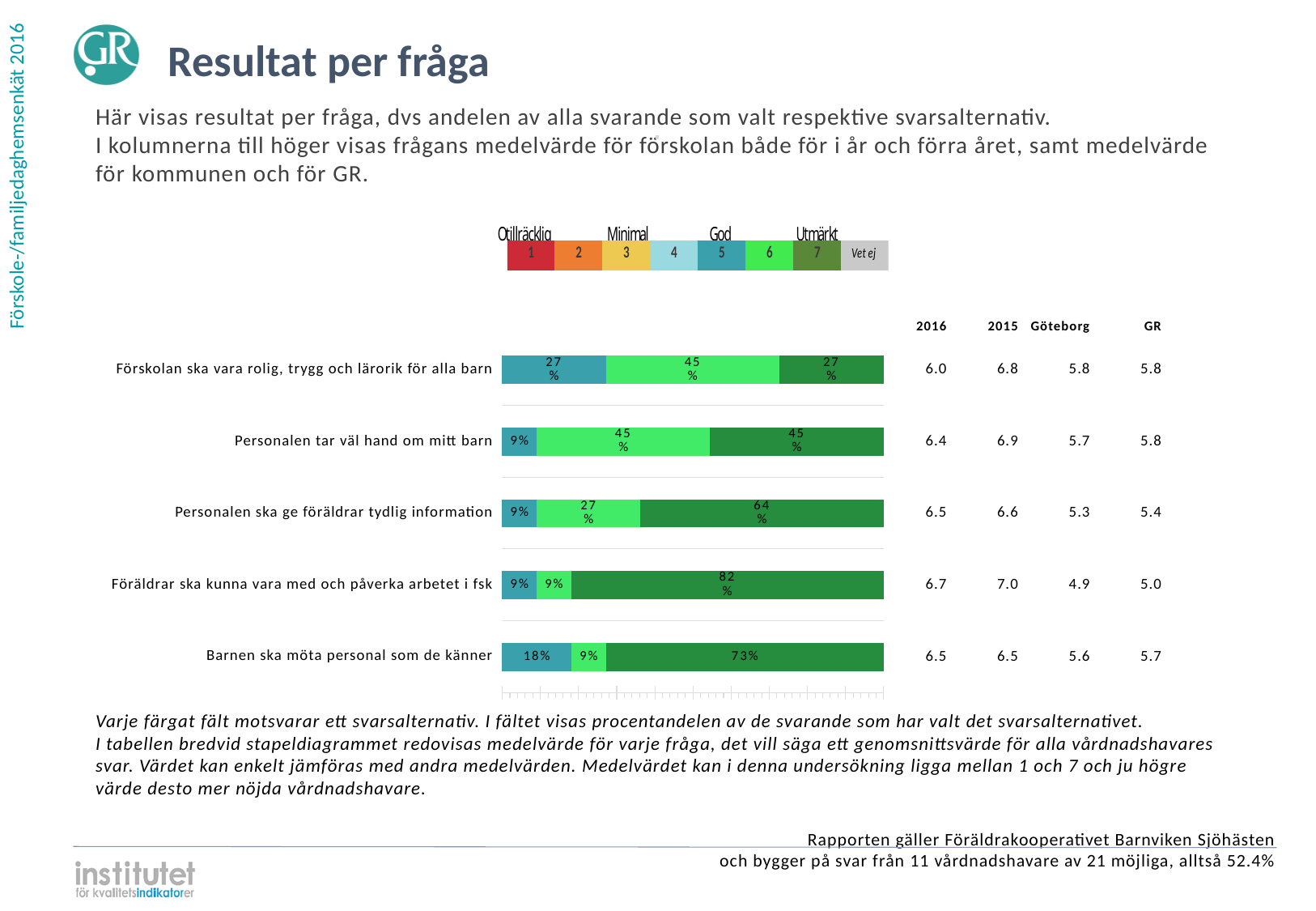
What percentage of respondents chose answer 5 (teal) for "Barnen ska möta personal som de känner"? 18% What percentage of respondents chose answer 6 (light green) for "Förskolan ska vara rolig, trygg och lärorik för alla barn"? 45% What label does the colour key give to the grey box at the right end of the scale? Vet ej What is the total of the stacked bar for "Barnen ska möta personal som de känner" (18% + 9% + 73%)? 100% How many questions (categories) are shown in the bar chart? 5 What kind of chart is used to show the results per question? bar chart Which question has the smallest share of respondents choosing answer 7 (dark green)? Förskolan ska vara rolig, trygg och lärorik för alla barn Which is larger: the answer 5 share for "Barnen ska möta personal som de känner" or for "Personalen tar väl hand om mitt barn"? Barnen ska möta personal som de känner What is the difference between the answer 7 share for "Personalen ska ge föräldrar tydlig information" (64%) and for "Personalen tar väl hand om mitt barn" (45%)? 19% What is the 2016 mean value shown for "Föräldrar ska kunna vara med och påverka arbetet i fsk"? 6.7 Which question has the largest share of respondents choosing answer 7 (dark green)? Föräldrar ska kunna vara med och påverka arbetet i fsk What percentage of respondents chose answer 7 (dark green) for "Föräldrar ska kunna vara med och påverka arbetet i fsk"? 82%